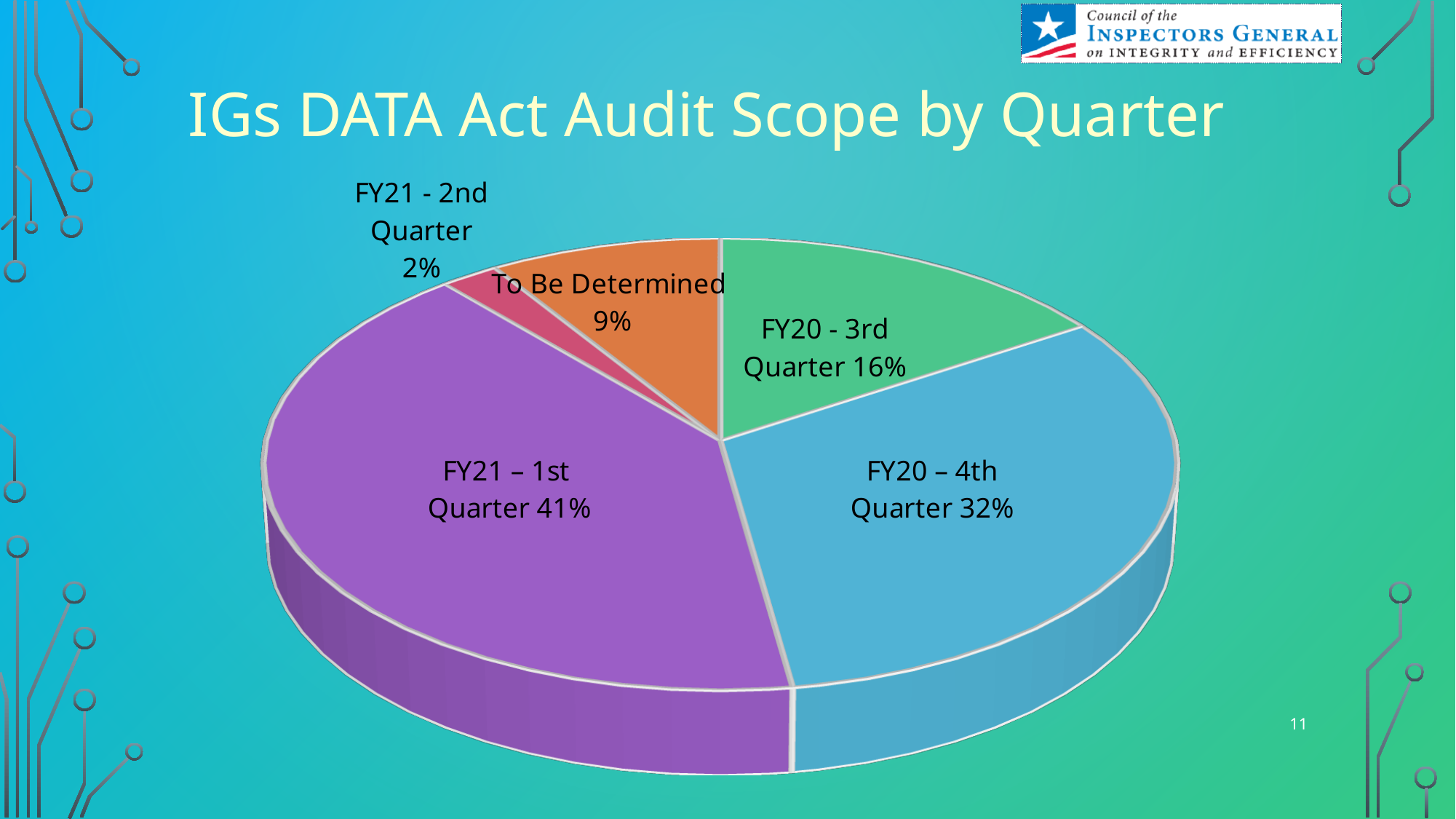
What share of the pie is FY20 - 3rd Quarter? 16% What share of the pie is FY20 – 4th Quarter? 32% What kind of chart is shown on the slide? Pie chart What share of the pie is To Be Determined? 9% Which is larger, FY20 - 3rd Quarter or To Be Determined? FY20 - 3rd Quarter Which slice is the largest? FY21 – 1st Quarter What is the difference in percentage points between FY21 – 1st Quarter and FY20 – 4th Quarter? 9 Which slice is the smallest? FY21 - 2nd Quarter What share of the pie is FY21 - 2nd Quarter? 2% How many slices does the pie chart have? 5 What is the title of the chart? IGs DATA Act Audit Scope by Quarter What share of the pie is FY21 – 1st Quarter? 41%